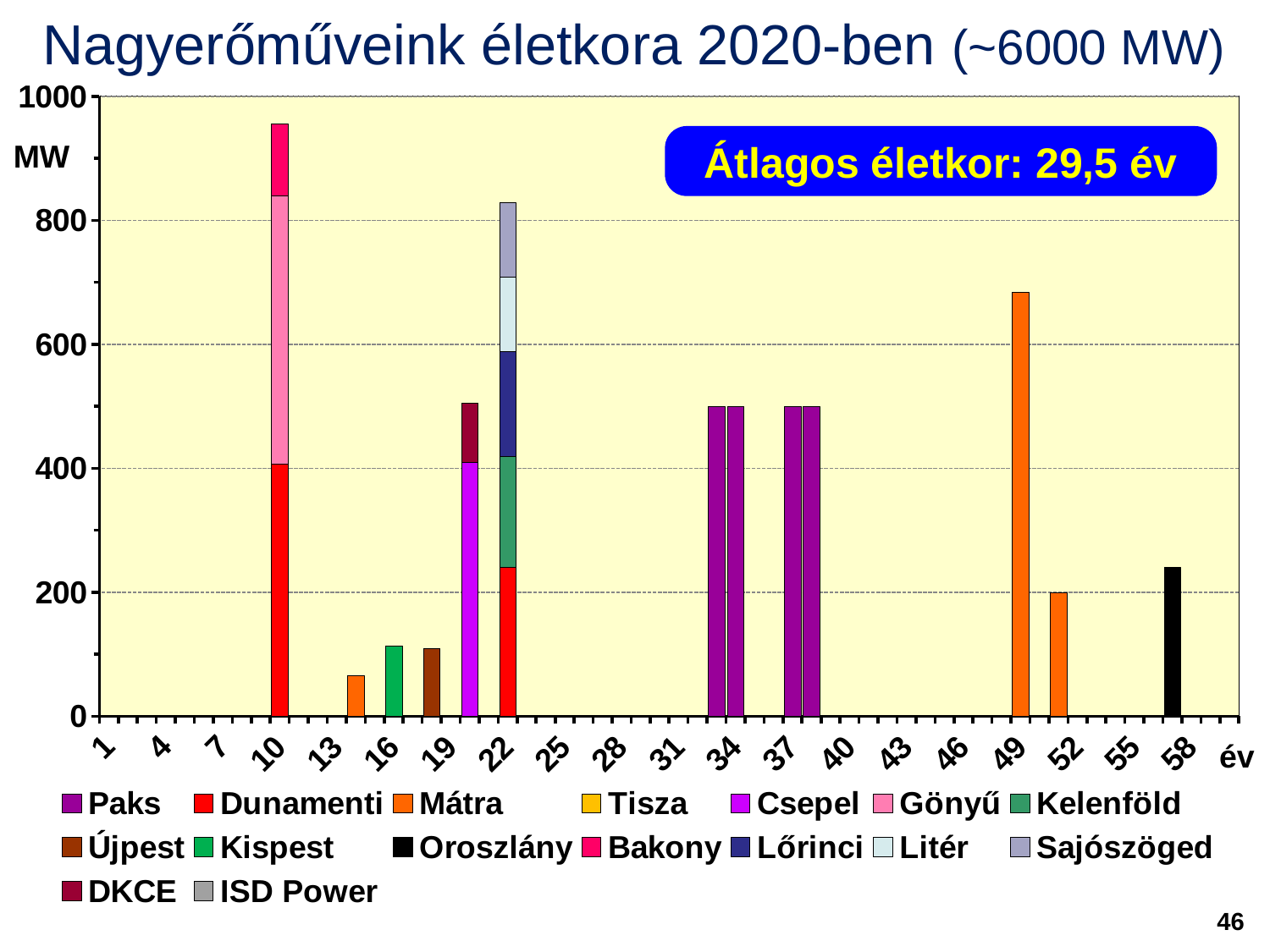
Is the value of the Mátra bar at age 49 greater or less than 600 MW? greater At which age (év) on the x axis is the tallest stacked bar? 10 Which is larger: the Mátra bar at age 49 or the Mátra bar at age 52? the bar at age 49 Is the total height of the stacked bar at age 22 greater or less than 600 MW? greater What average age (Átlagos életkor) is stated in the box on the chart? 29,5 év Is the value of the Oroszlány bar at age 58 greater or less than 400 MW? less What kind of chart is shown on the slide? bar chart What colour represents Paks in the legend? purple How many series does the legend list? 16